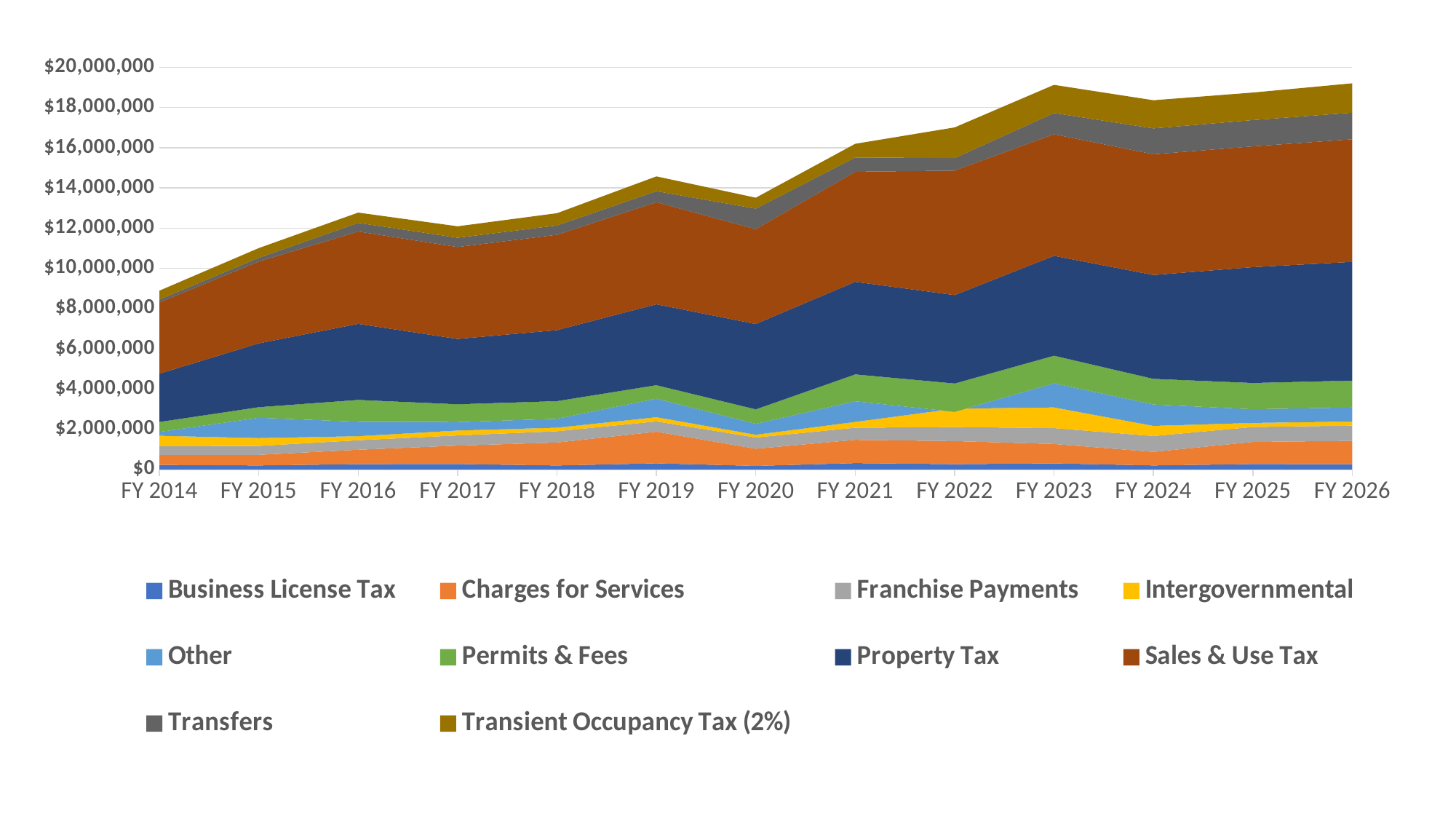
Is the total stacked value for FY 2023 greater or less than $18,000,000? greater How many fiscal years are plotted along the x axis? 13 Which fiscal year is the first on the x axis? FY 2014 Which has the larger total stacked value, FY 2019 or FY 2020? FY 2019 Does the total stacked value generally rise or fall from FY 2014 to FY 2026? Rise Which series occupies the largest area of the chart? Sales & Use Tax Is the total stacked value for FY 2026 greater or less than $18,000,000? greater Which fiscal year has the lowest total stacked value? FY 2014 What kind of chart is shown on the slide? Stacked area chart Is the total stacked value for FY 2014 greater or less than $10,000,000? less How many series does the legend list? 10